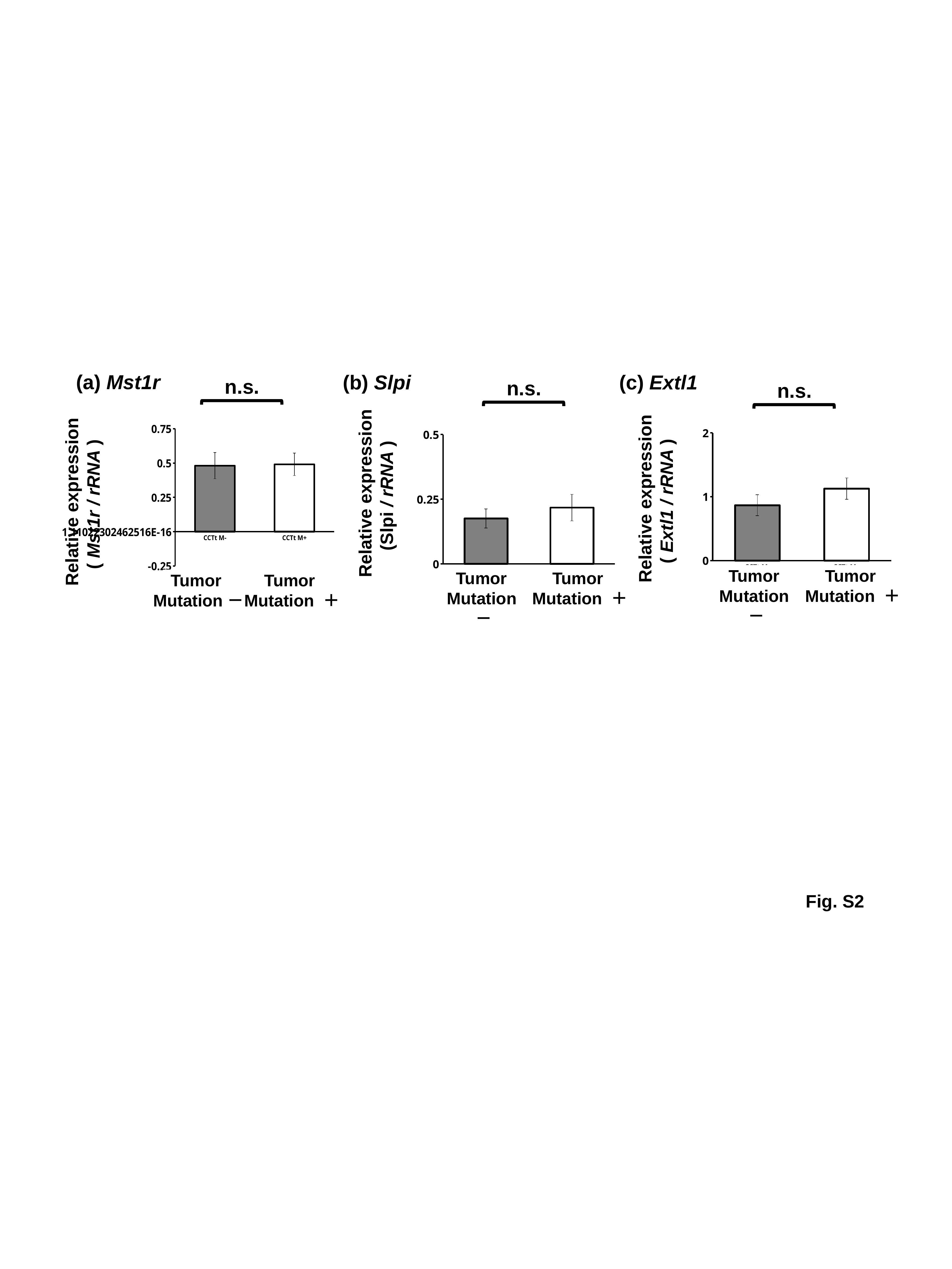
In chart (b) Slpi, is the value for Tumor Mutation − greater or less than 0.25? less In chart (a) Mst1r, is the value for Tumor Mutation − greater or less than 0.25? greater What is the y-axis label of chart (b) Slpi? Relative expression (Slpi / rRNA) In chart (c) Extl1, is the value for Tumor Mutation − greater or less than 1? less What annotation is shown above the bars in chart (c) Extl1? n.s. In chart (c) Extl1, which category has the highest value? Tumor Mutation + In chart (c) Extl1, which category has the lowest value? Tumor Mutation − In chart (b) Slpi, which bar is taller, Tumor Mutation − or Tumor Mutation +? Tumor Mutation + How many bars are plotted in chart (b) Slpi? 2 What kind of chart is chart (a) Mst1r? bar chart